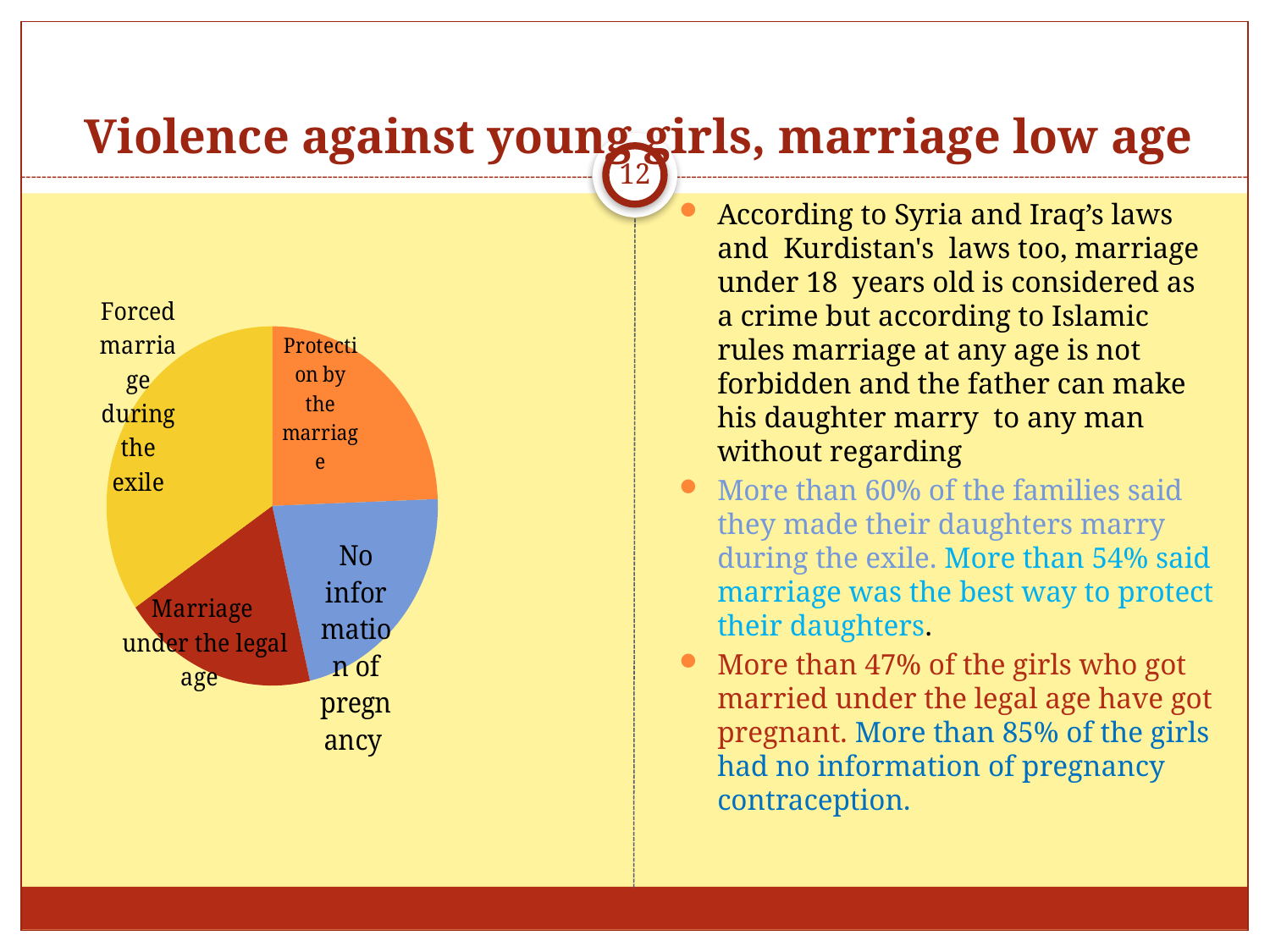
Which slice of the pie chart is the largest? Forced marriage during the exile Which slice of the pie chart is coloured blue? No information of pregnancy How many slices does the pie chart have? 4 Which slice is larger: "Protection by the marriage" or "Marriage under the legal age"? Protection by the marriage What colour is the "Forced marriage during the exile" slice of the pie chart? yellow What kind of chart is shown on the slide? pie chart Which slice of the pie chart is the smallest? Marriage under the legal age Which slice is larger: "No information of pregnancy" or "Marriage under the legal age"? No information of pregnancy Which slice is larger: "Forced marriage during the exile" or "No information of pregnancy"? Forced marriage during the exile